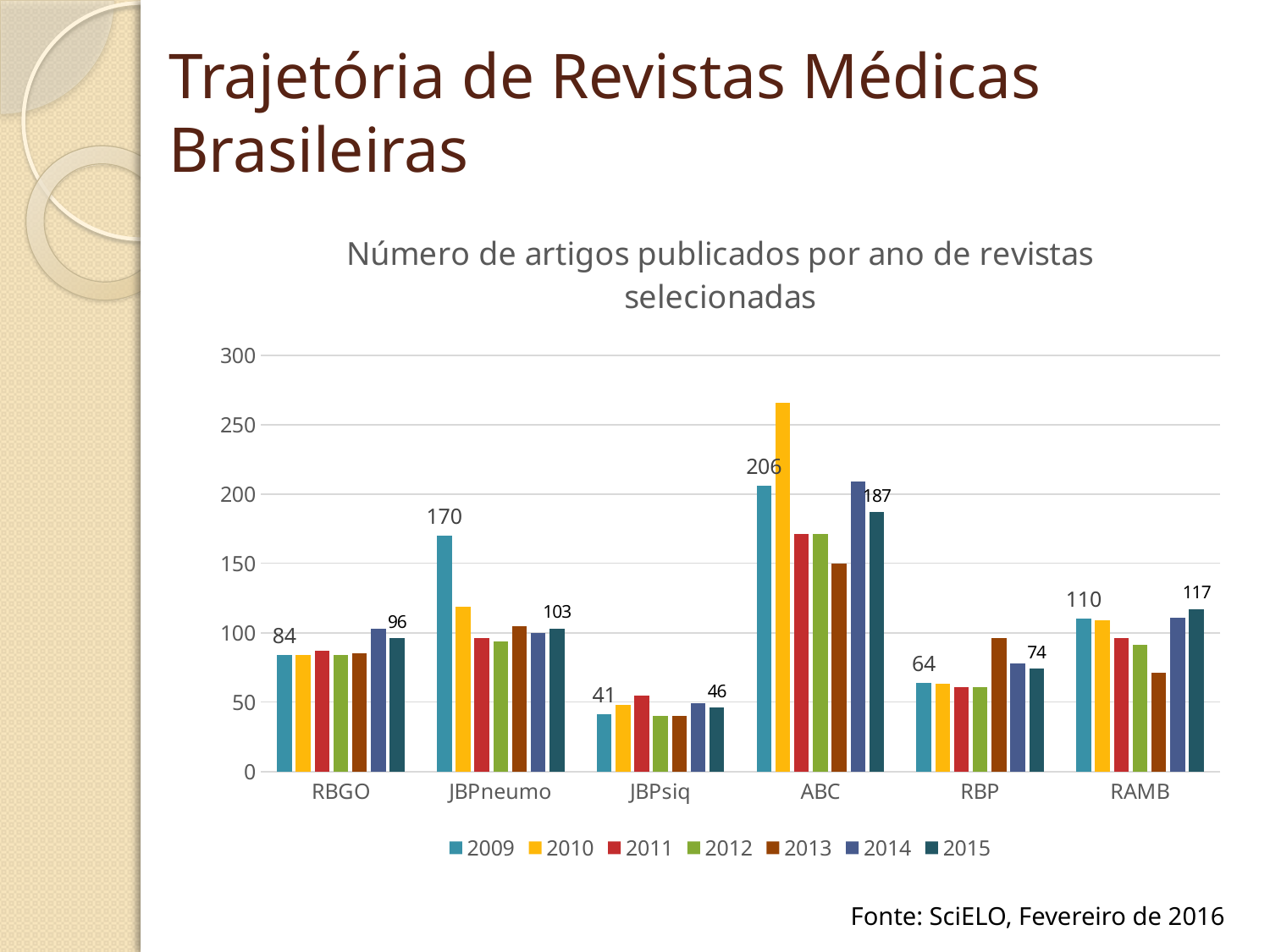
What is the value for JBPneumo in 2009? 170 What is the value for RAMB in 2015? 117 What is the value for RBGO in 2009? 84 By how much did the value for JBPneumo fall from 2009 to 2015? 67 How many journals are shown on the x axis? 6 Is the value for ABC in 2010 greater or less than 250? greater Which journal has the lowest value in 2015? JBPsiq Which journal has the highest value in 2009? ABC For RBP, which year has the larger value, 2009 or 2015? 2015 What is the difference between the 2009 and 2015 values for ABC? 19 What is the value for ABC in 2015? 187 How many series does the legend list? 7